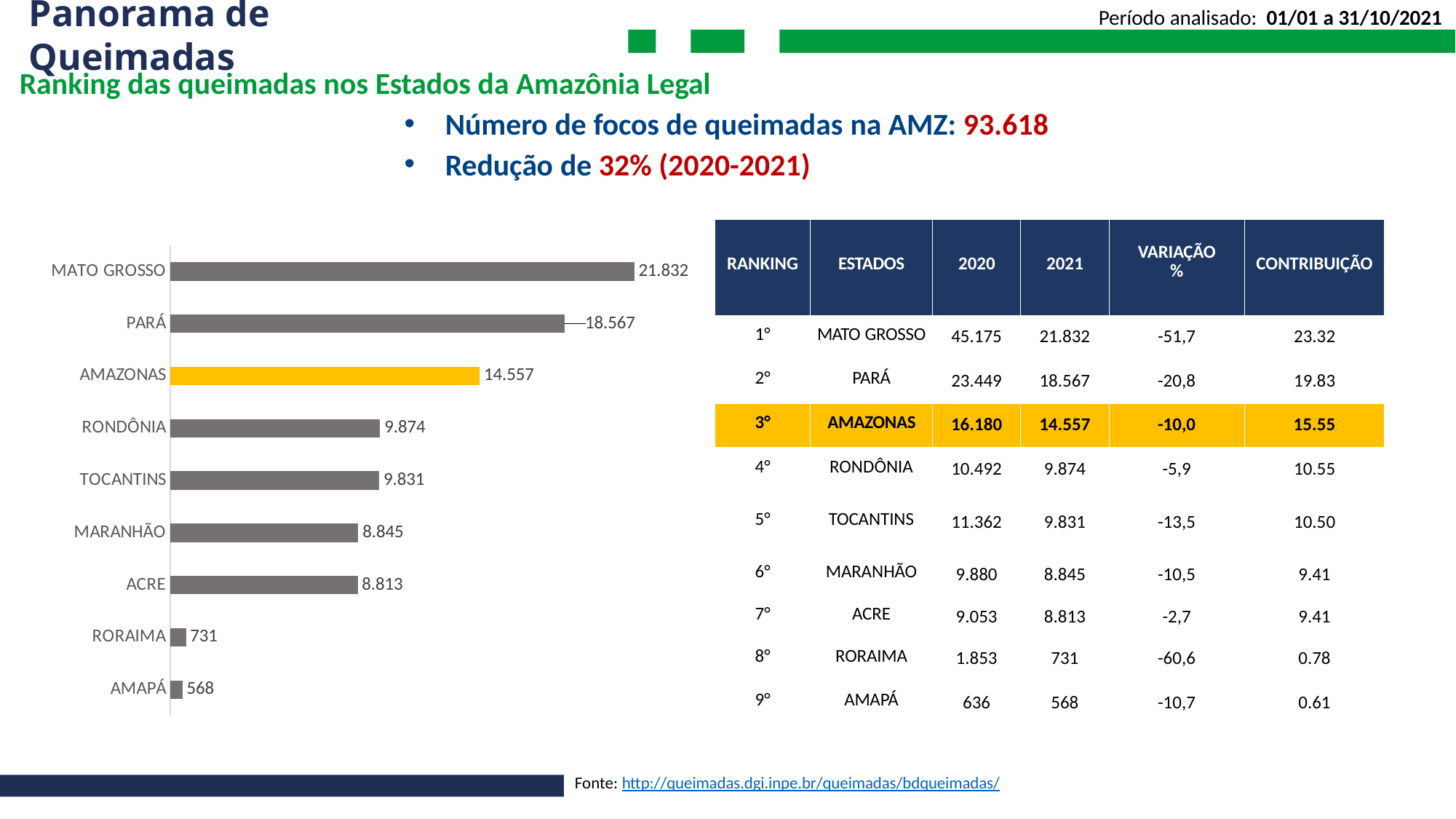
What type of chart is shown on the slide? bar chart Which state has the highest value in the bar chart? MATO GROSSO Which state's bar is highlighted in yellow in the bar chart? AMAZONAS What is the difference between the values for MATO GROSSO and PARÁ in the bar chart? 3.265 How many states are shown in the bar chart? 9 Do the bar values increase or decrease from the top of the chart to the bottom? decrease What is the value shown for AMAZONAS in the bar chart? 14.557 Which state has the lowest value in the bar chart? AMAPÁ What is the value shown for RORAIMA in the bar chart? 731 What is the value shown for MATO GROSSO in the bar chart? 21.832 Which has a larger value in the bar chart, PARÁ or AMAZONAS? PARÁ What is the difference between the values for RORAIMA and AMAPÁ in the bar chart? 163